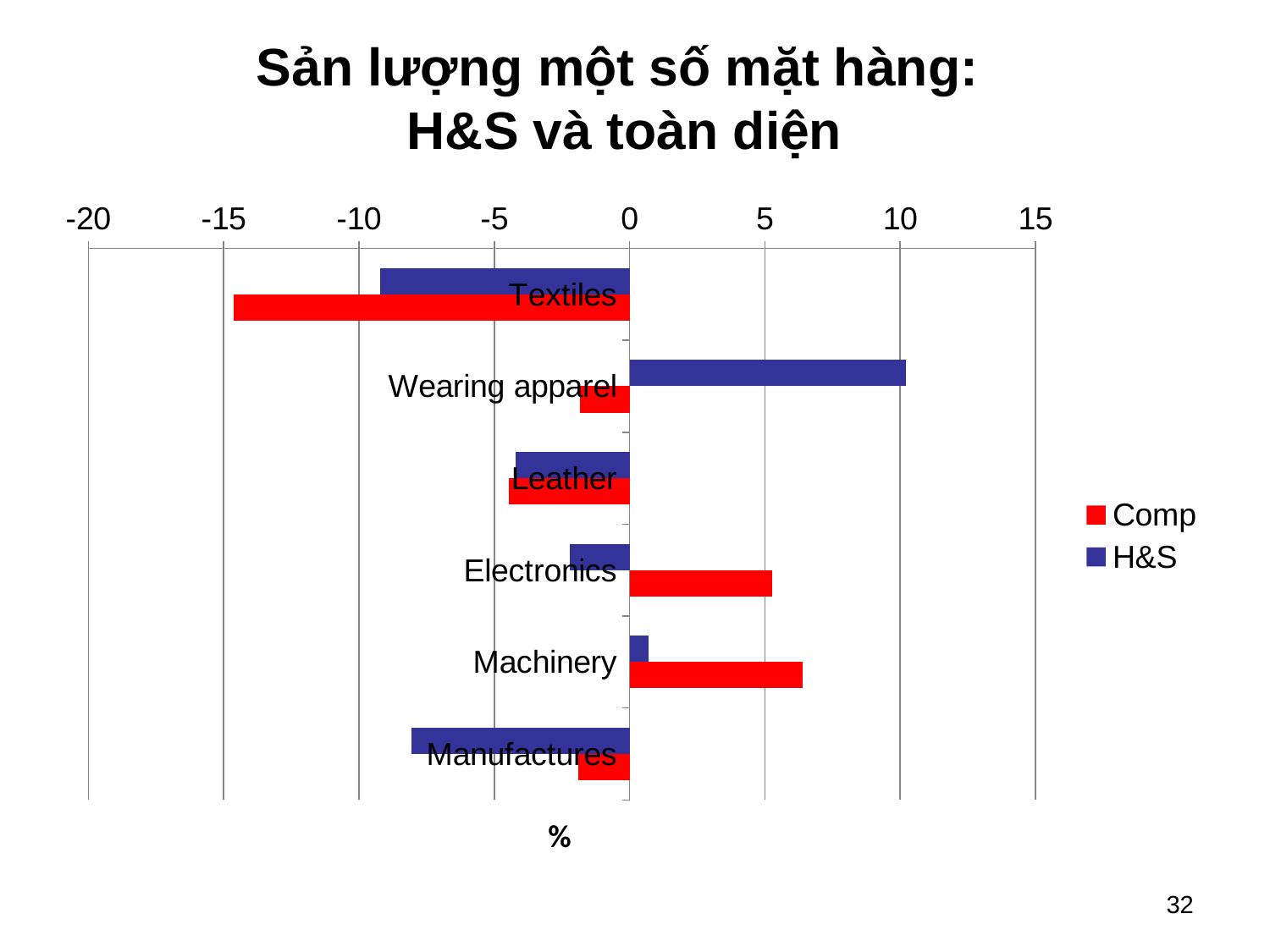
Which category has the highest H&S value? Wearing apparel Which colour represents the Comp series in the legend? red For Electronics, which series has the larger value, Comp or H&S? Comp For Textiles, which series has the larger value, Comp or H&S? H&S How many categories are plotted on the chart? 6 Is the Comp value for Textiles greater or less than -10? less What kind of chart is shown on the slide? bar chart Which category has the lowest Comp value? Textiles Which category has the highest Comp value? Machinery How many series does the legend list? 2